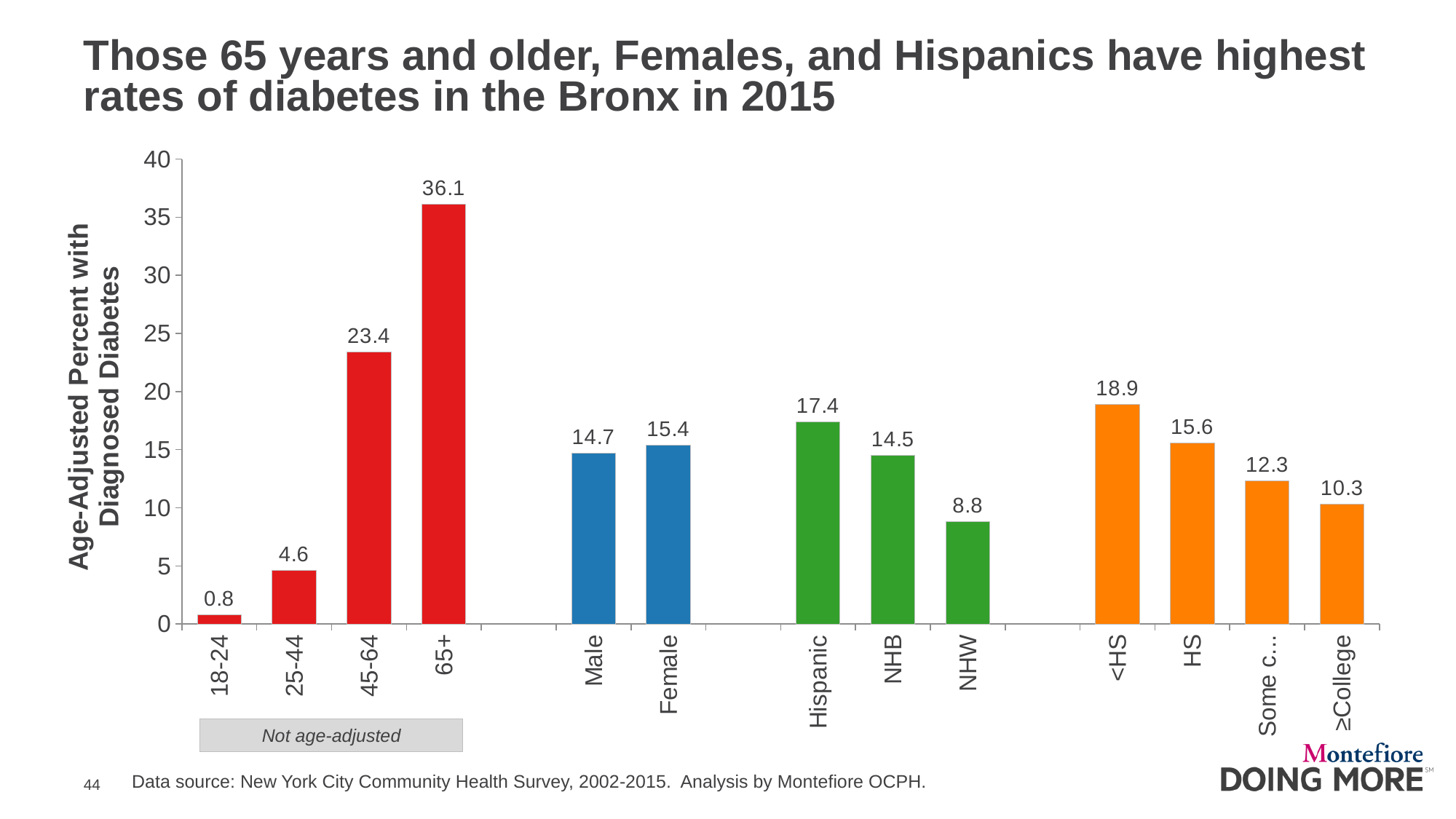
What is the difference between the values for Hispanic and NHW? 8.6 What is the value shown for Hispanic? 17.4 Which category has the lowest value in the chart? 18-24 What is the age-adjusted percent with diagnosed diabetes for the 65+ age group? 36.1 How many bars are plotted in the chart? 13 What is the value shown for <HS? 18.9 What kind of chart is shown on the slide? Bar chart What is the value shown for Female? 15.4 Which has a higher value, Male or Female? Female Which category has the highest value in the chart? 65+ What is the difference between the values for 65+ and 45-64? 12.7 Which has a higher value, HS or ≥College? HS